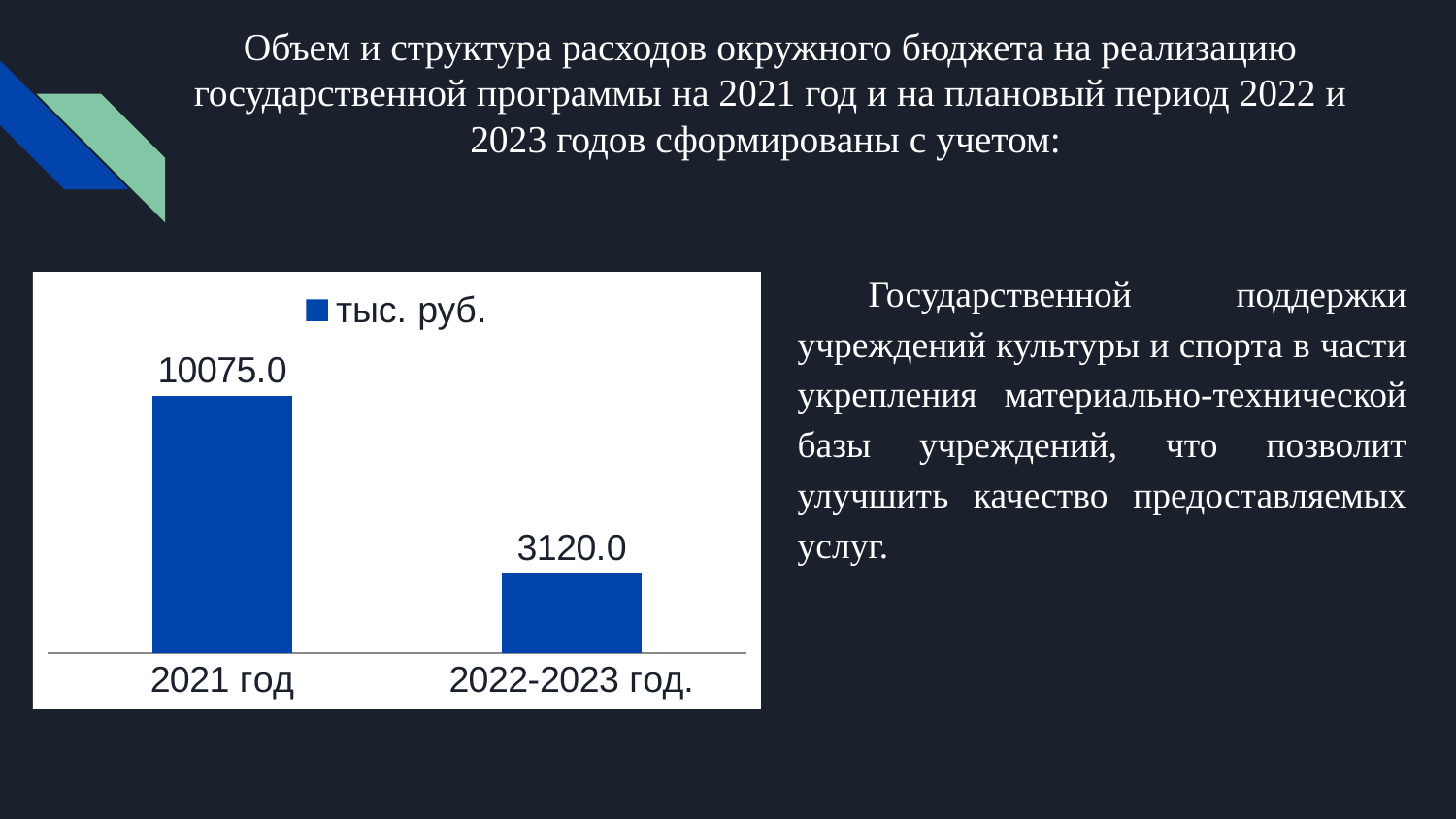
What is the value for 2022-2023 год.? 3120.0 What kind of chart is shown on the slide? bar chart What colour are the bars on the chart? blue Which category has the highest value? 2021 год Which category has the lowest value? 2022-2023 год. What is the legend entry of the series shown on the chart? тыс. руб. How many categories are shown on the chart? 2 What is the value for 2021 год? 10075.0 Do the values rise or fall from 2021 год to 2022-2023 год.? fall Which is larger, the value for 2021 год or the value for 2022-2023 год.? 2021 год How many series does the legend list? 1 What is the difference between the values for 2021 год and 2022-2023 год.? 6955.0